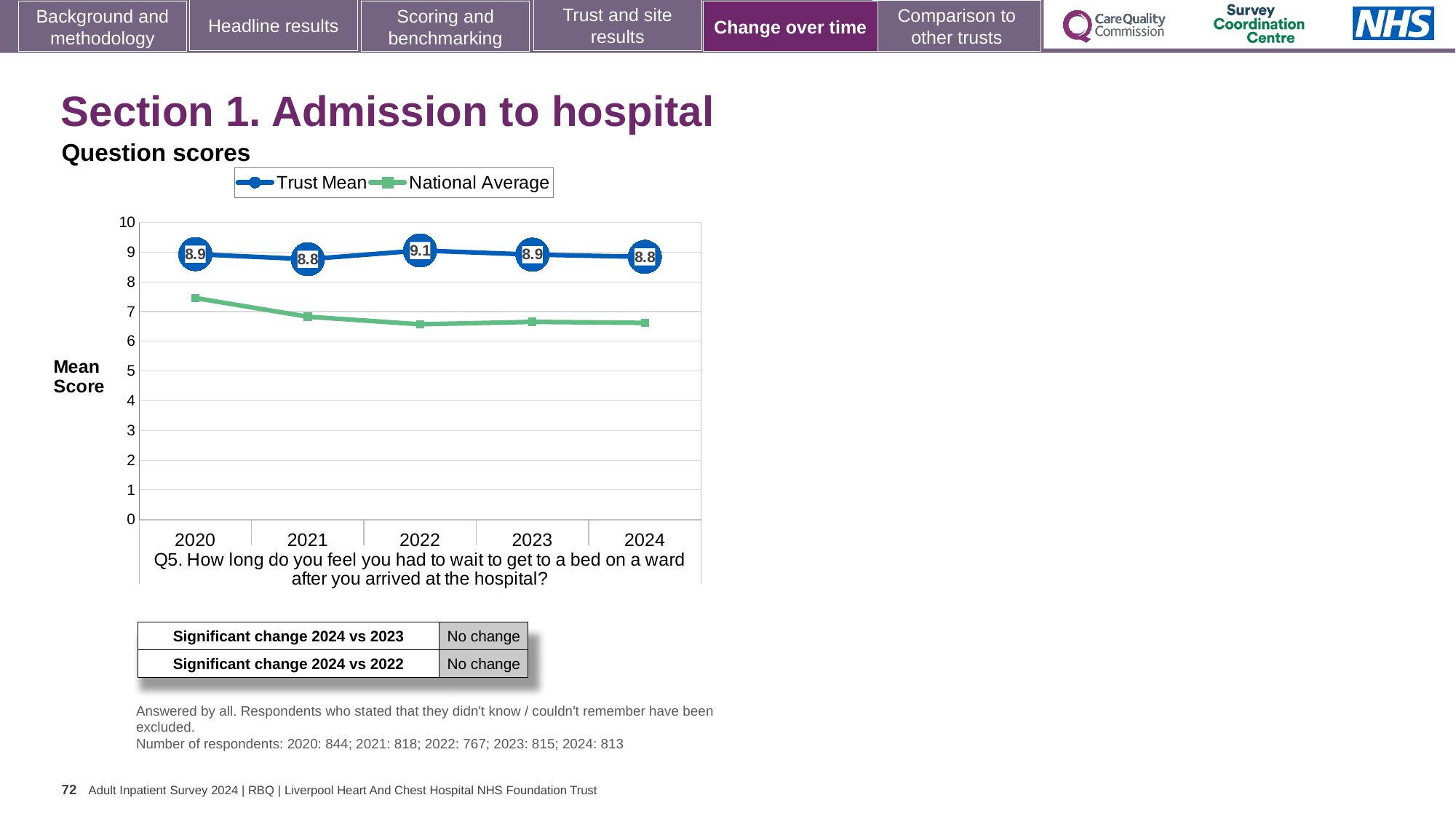
What is the Trust Mean score for 2022? 9.1 What is the Trust Mean score for 2020? 8.9 How many series does the legend list? 2 Is the National Average value for 2022 greater or less than 7? less In which year is the Trust Mean score highest? 2022 How many years are plotted on the x axis? 5 What is the Trust Mean score for 2024? 8.8 In 2020, which series has the higher value, Trust Mean or National Average? Trust Mean What kind of chart is shown on the slide? Line chart What is the difference between the Trust Mean scores for 2022 and 2021? 0.3 Does the National Average rise or fall from 2020 to 2022? Fall Is the National Average value for 2020 greater or less than 7? greater